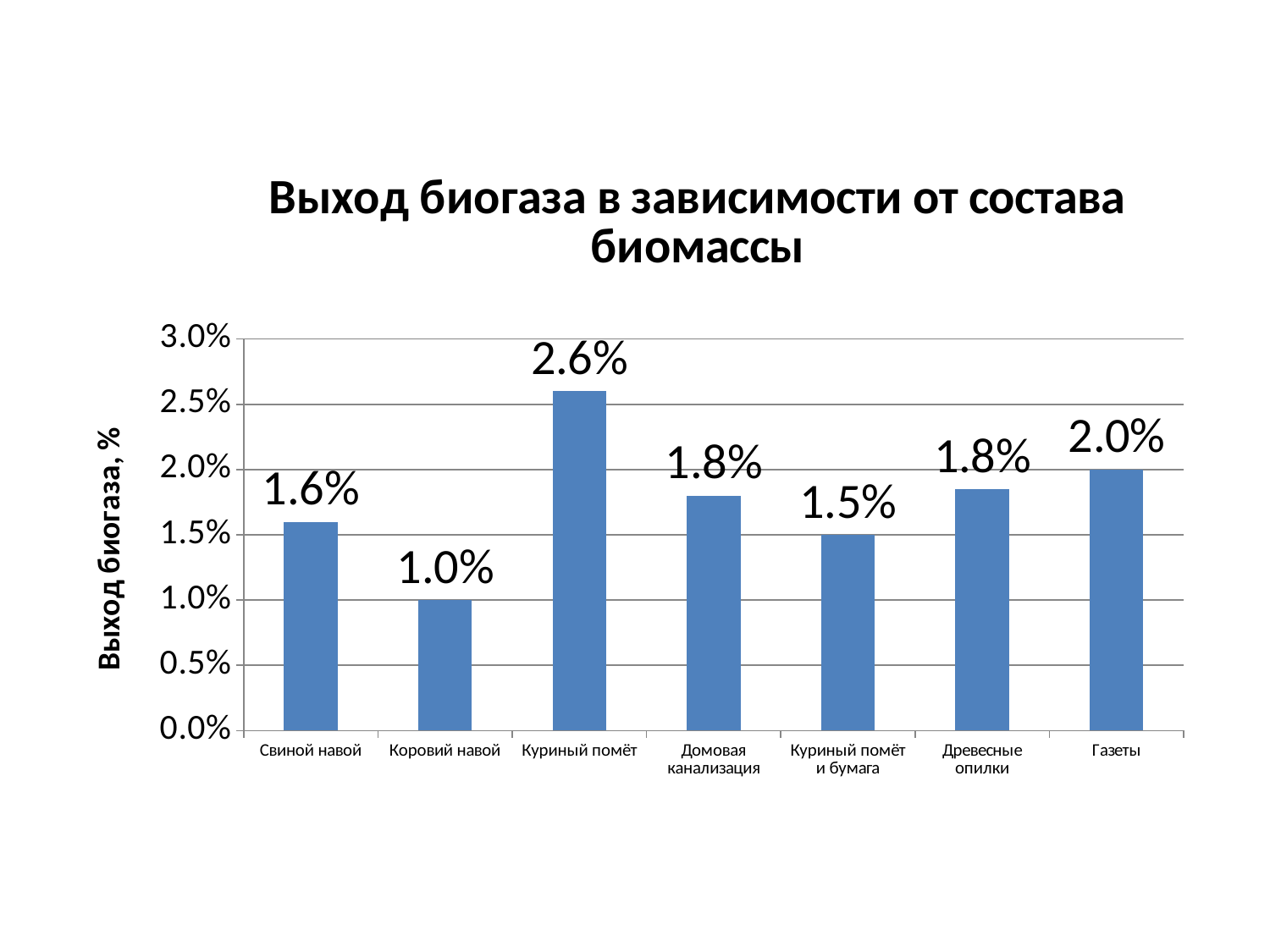
Which has a higher biogas yield, Свиной навой or Газеты? Газеты What is the biogas yield for Куриный помёт? 2.6% What is the biogas yield for Коровий навой? 1.0% What type of chart is shown on the slide? bar chart How many categories are shown on the x axis? 7 What is the label of the vertical axis? Выход биогаза, % Which category has the highest biogas yield? Куриный помёт Which category has the lowest biogas yield? Коровий навой What is the difference between the biogas yield for Куриный помёт and for Коровий навой? 1.6% What is the title of the chart? Выход биогаза в зависимости от состава биомассы What is the biogas yield for Газеты? 2.0% What is the biogas yield for Куриный помёт и бумага? 1.5%